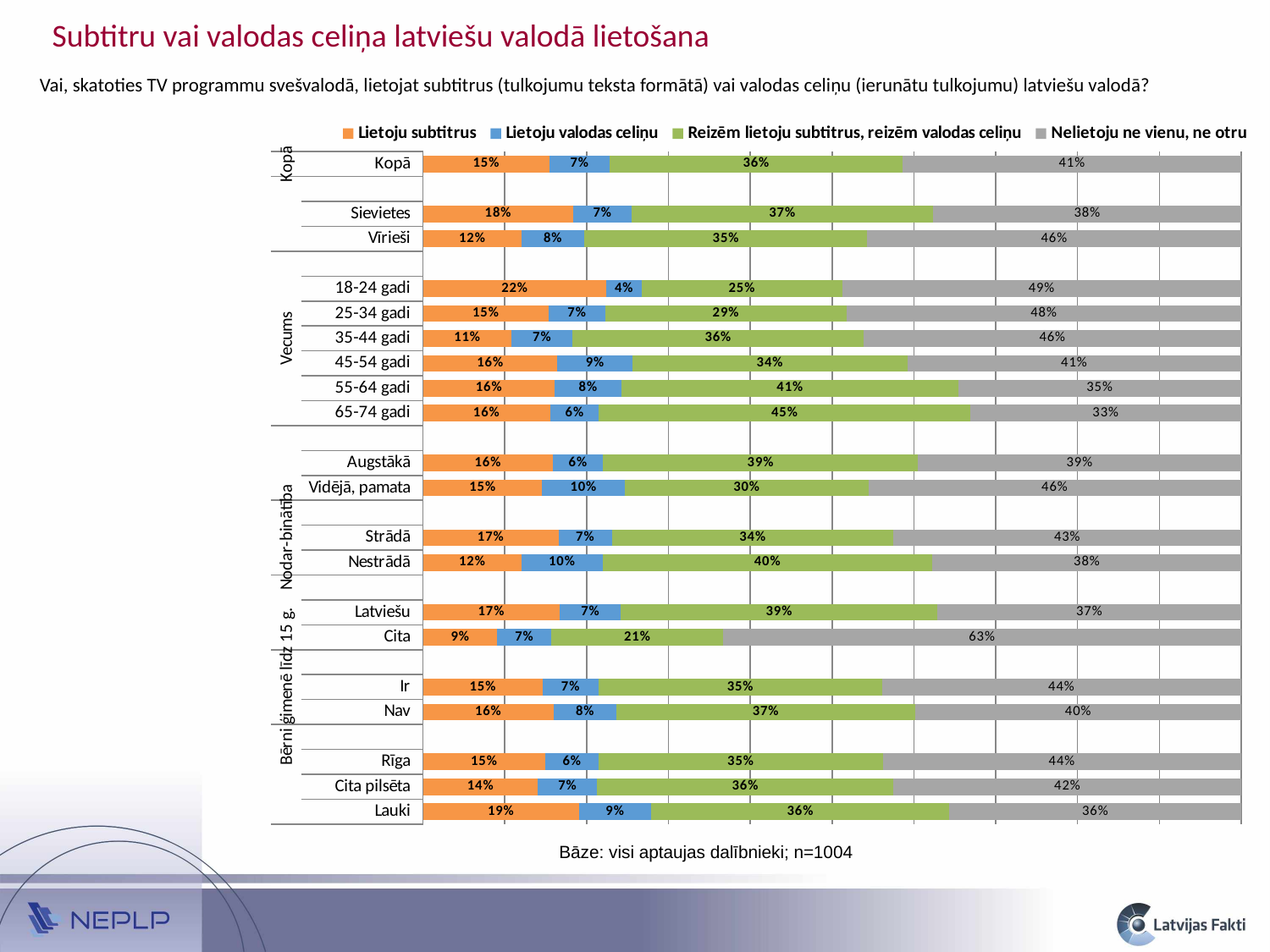
What is the total of the stacked bar for Lauki? 100% How many series does the legend list? 4 Which category has the lowest value for 'Lietoju valodas celiņu'? 18-24 gadi What colour represents 'Lietoju valodas celiņu' in the chart? Blue What is the value of 'Lietoju subtitrus' for 18-24 gadi? 22% What is the value of 'Nelietoju ne vienu, ne otru' for Kopā? 41% Which has a larger 'Reizēm lietoju subtitrus, reizēm valodas celiņu' value, Nestrādā or Strādā? Nestrādā What is the difference in 'Lietoju subtitrus' between Sievietes and Vīrieši? 6 percentage points What is the value of 'Reizēm lietoju subtitrus, reizēm valodas celiņu' for 65-74 gadi? 45% Which category has the highest value for 'Nelietoju ne vienu, ne otru'? Cita How many categories (rows) are plotted in the chart? 20 What type of chart is shown on the slide? Stacked bar chart